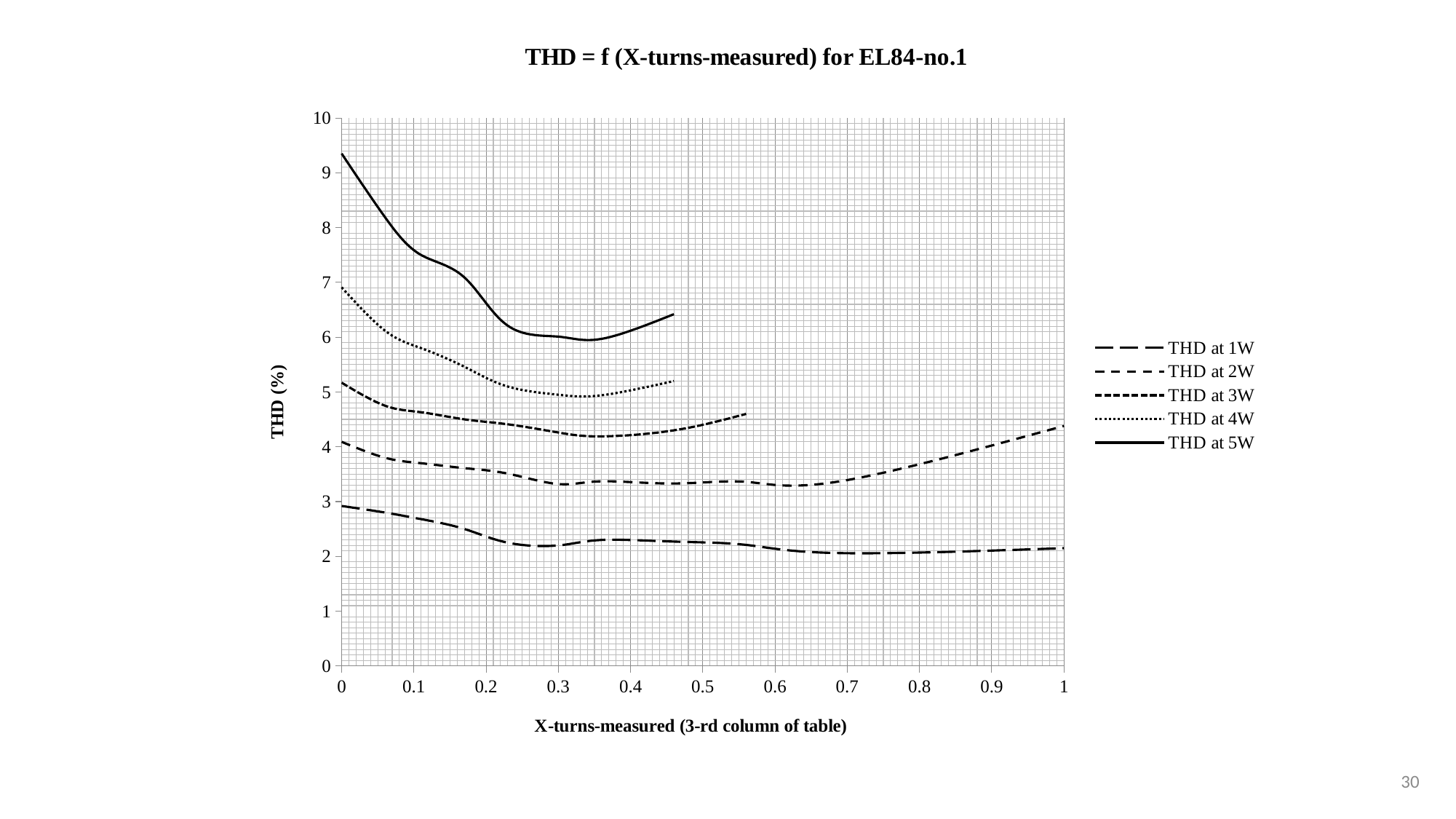
Is the value of THD at 1W at X-turns-measured = 0 greater or less than 4? less Does the THD at 5W series rise or fall between X-turns-measured = 0 and 0.3? fall Which series reaches the highest THD value on the chart? THD at 5W Is the value of THD at 4W at X-turns-measured = 0 greater or less than 6? greater What is the label of the x axis? X-turns-measured (3-rd column of table) How many series does the legend list? 5 What is the title of the chart? THD = f (X-turns-measured) for EL84-no.1 What kind of chart is shown on the slide? line chart Is the value of THD at 2W at X-turns-measured = 1 greater or less than 4? greater At X-turns-measured = 1, which series has the higher value, THD at 2W or THD at 1W? THD at 2W At X-turns-measured = 0, which series has the higher value, THD at 5W or THD at 1W? THD at 5W